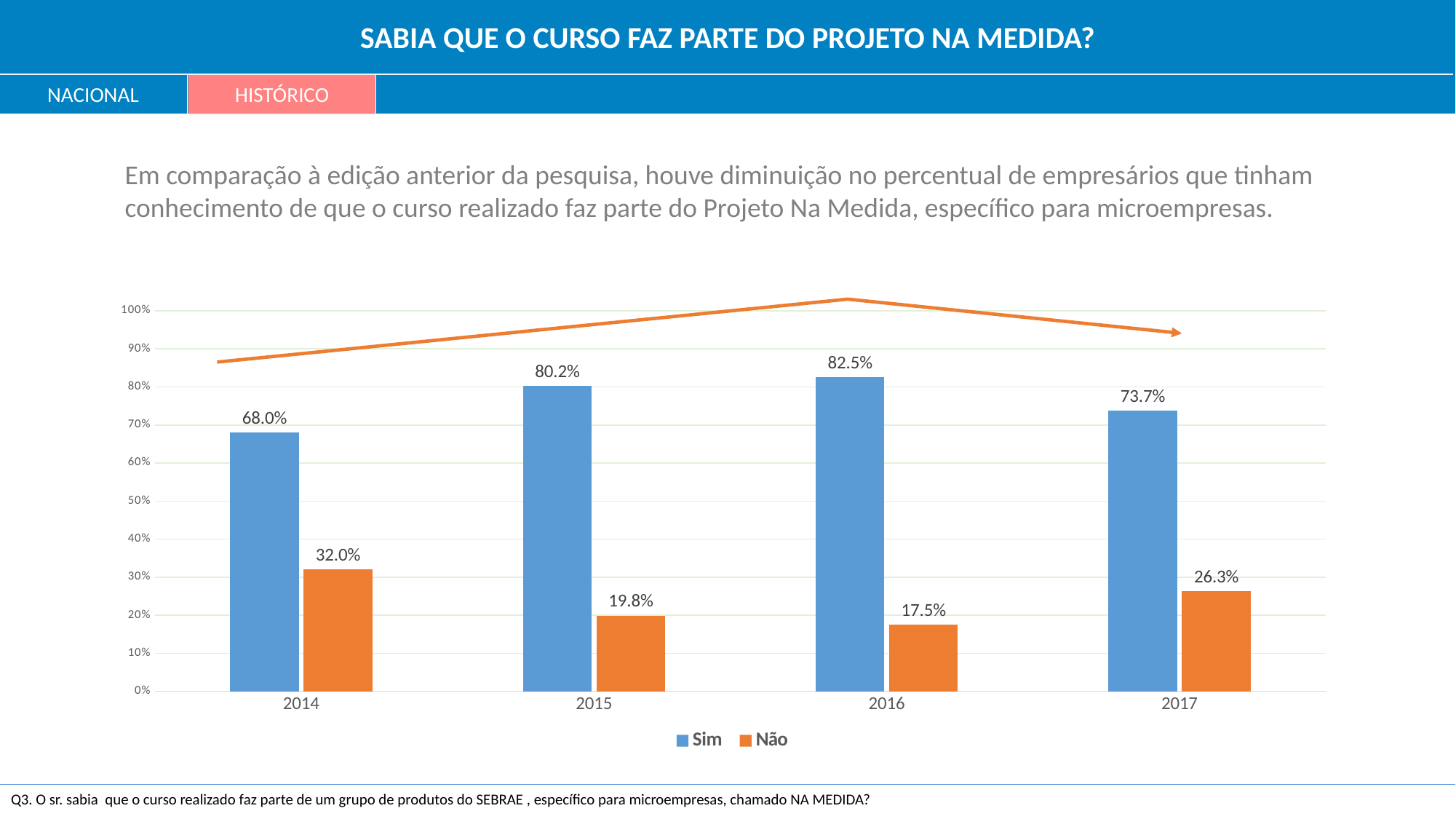
In which year is the Não value lowest? 2016 Which is larger, the Não value for 2015 or the Não value for 2017? 2017 What is the value for Sim in 2016? 82.5% Is the value for Sim in 2014 greater or less than 70%? less How many years are shown on the x axis? 4 How many series does the legend list? 2 In which year is the Sim value highest? 2016 Does the Sim value rise or fall from 2016 to 2017? fall What is the difference between the Sim values for 2016 and 2017? 8.8% What kind of chart is shown on the slide? bar chart What is the value for Sim in 2017? 73.7% What is the value for Não in 2014? 32.0%